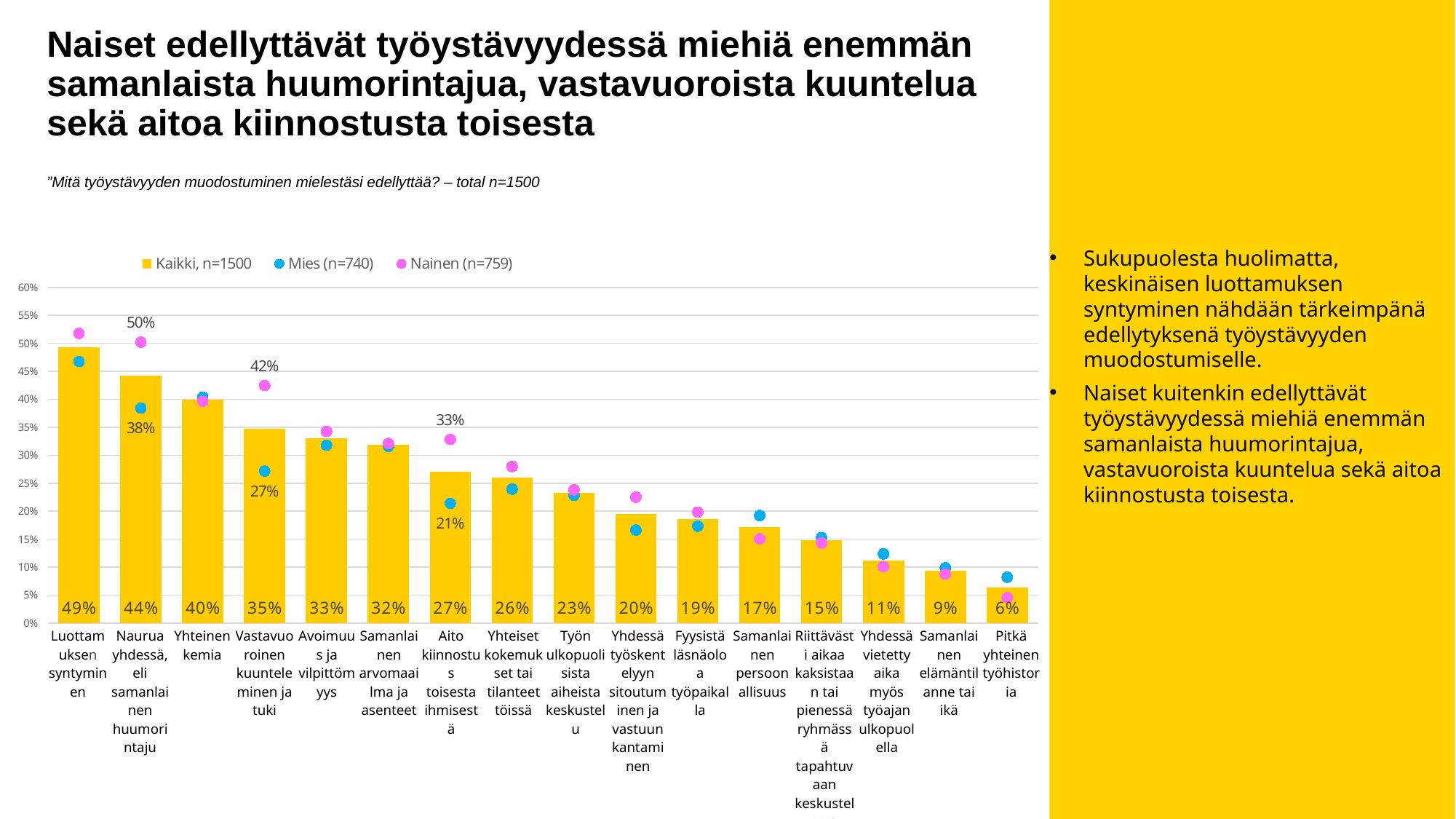
What is the Mies (n=740) value for 'Vastavuoroinen kuunteleminen ja tuki'? 27% Do the Kaikki bar values rise or fall from left to right along the x axis? Fall How many categories are shown on the x axis of the chart? 16 Which category has the highest Kaikki bar? Luottamuksen syntyminen Is the Nainen value for 'Luottamuksen syntyminen' greater or less than 50%? greater What is the value of the Kaikki bar for 'Luottamuksen syntyminen'? 49% What kind of chart is shown on the slide? Bar chart with dot markers How many series does the chart legend list? 3 For 'Naurua yhdessä, eli samanlainen huumorintaju', which is larger: the Mies value or the Nainen value? Nainen What is the Nainen (n=759) value for 'Naurua yhdessä, eli samanlainen huumorintaju'? 50% What is the difference between the Nainen and Mies values for 'Aito kiinnostus toisesta ihmisestä'? 12% Which category has the lowest Kaikki bar? Pitkä yhteinen työhistoria